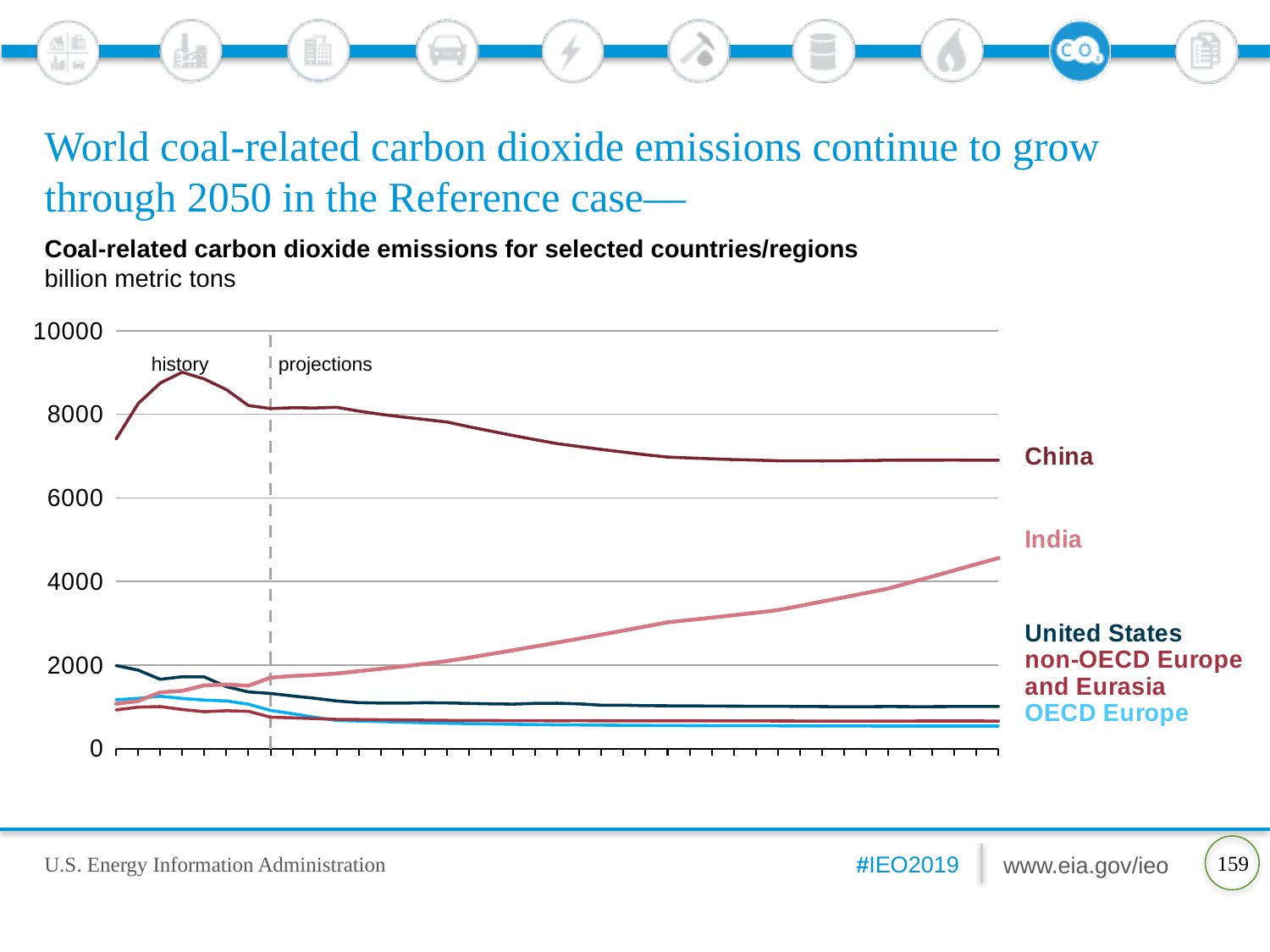
Which country/region has the highest coal-related carbon dioxide emissions at the end of the projection period? China Is India's value at the end of the projection period greater or less than 4000? greater Do China's coal-related carbon dioxide emissions rise or fall over the projection period? fall What two labels appear on either side of the dashed vertical line on the chart? history and projections Is China's value at the end of the projection period greater or less than 6000? greater Which country/region has the second-highest coal-related carbon dioxide emissions at the end of the projection period? India What unit is used for the values on the chart? billion metric tons How many countries/regions are plotted as series on the chart? 5 What kind of chart is shown on the slide? line chart Is China's value at the end of the projection period greater or less than 8000? less Do India's coal-related carbon dioxide emissions rise or fall over the projection period? rise